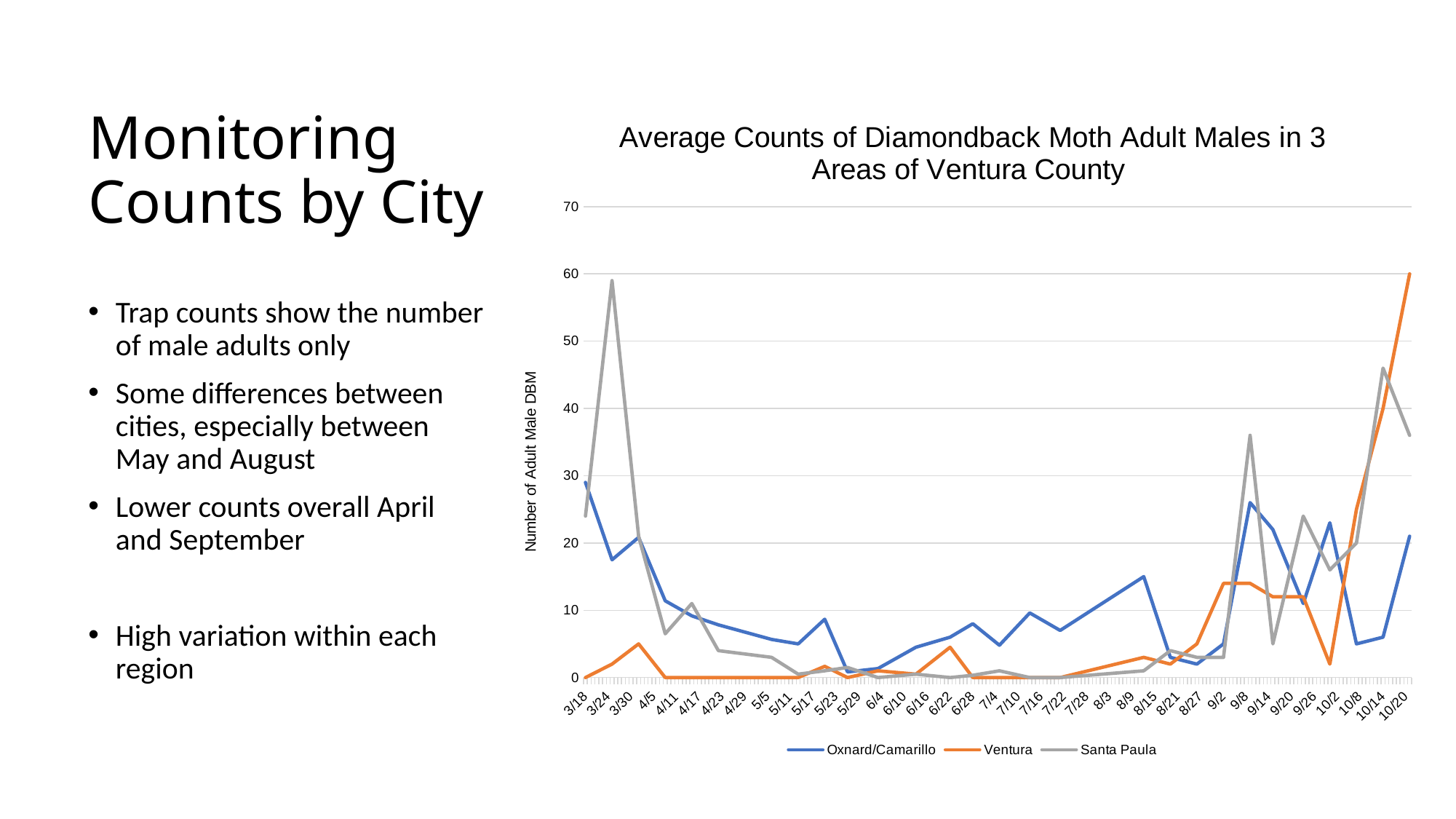
How many series does the legend list? 3 What is the label on the vertical axis of the chart? Number of Adult Male DBM Does the Ventura line rise or fall between 10/2 and 10/20? rise What kind of chart is shown on the slide? line chart On 3/24, which series has the larger value, Santa Paula or Oxnard/Camarillo? Santa Paula Is the value for Ventura on 10/20 greater or less than 50? greater Is the value for Santa Paula on 3/24 greater or less than 50? greater On 10/20, which series has the larger value, Ventura or Oxnard/Camarillo? Ventura Is the value for Ventura on 4/11 greater or less than 10? less How many dates are shown along the x axis? 37 What is the title of the chart? Average Counts of Diamondback Moth Adult Males in 3 Areas of Ventura County